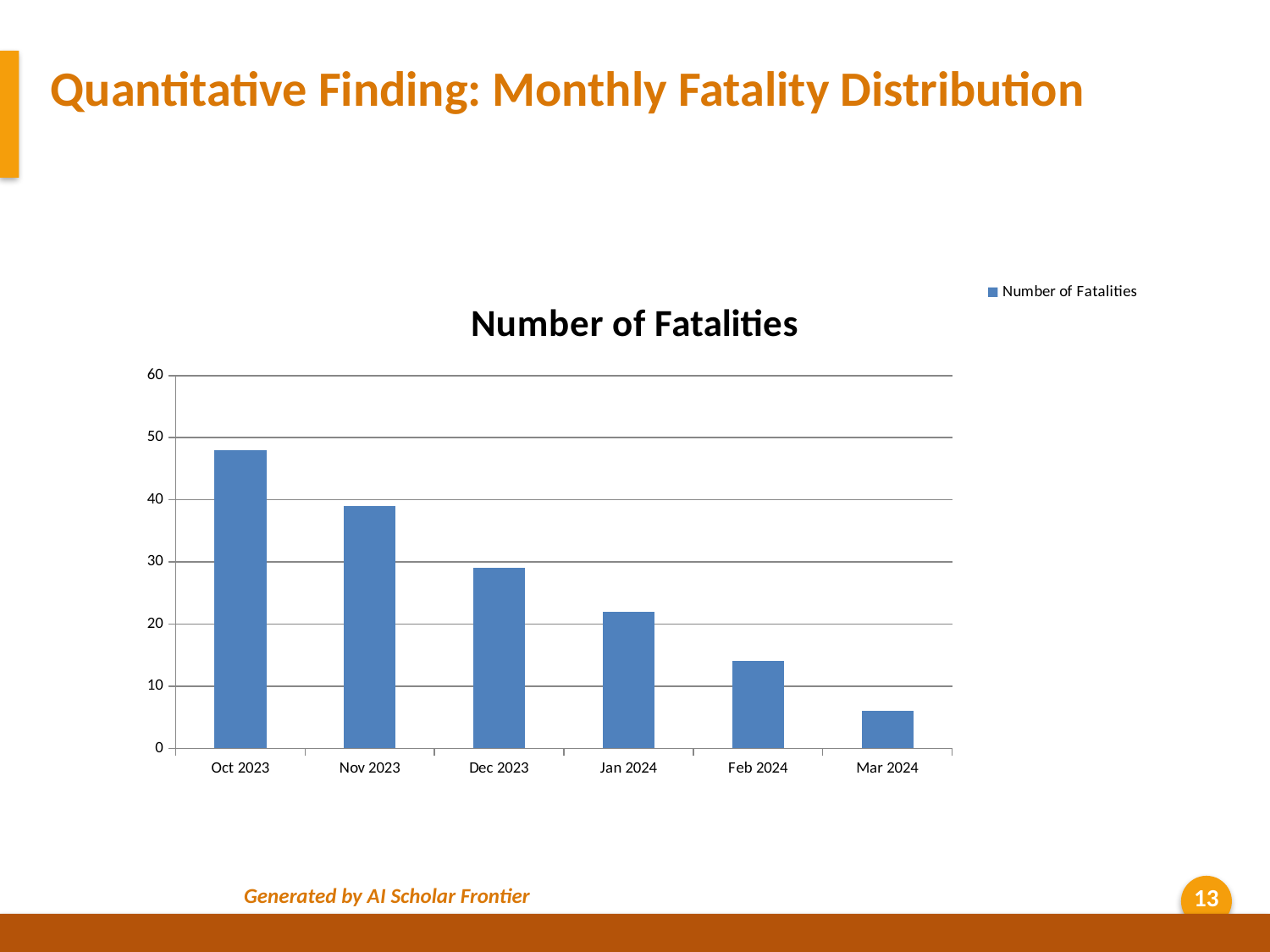
Is the value for Mar 2024 greater or less than 10? less How many series does the legend list? 1 Which month has the highest number of fatalities? Oct 2023 Which month has the lowest number of fatalities? Mar 2024 Is the value for Oct 2023 greater or less than 40? greater What is the title of the chart? Number of Fatalities Which is larger, the value for Nov 2023 or the value for Jan 2024? Nov 2023 How many months are shown on the x axis of the chart? 6 Is the value for Feb 2024 greater or less than 10? greater Do the values rise or fall from Oct 2023 to Mar 2024? fall What kind of chart is shown on the slide? bar chart